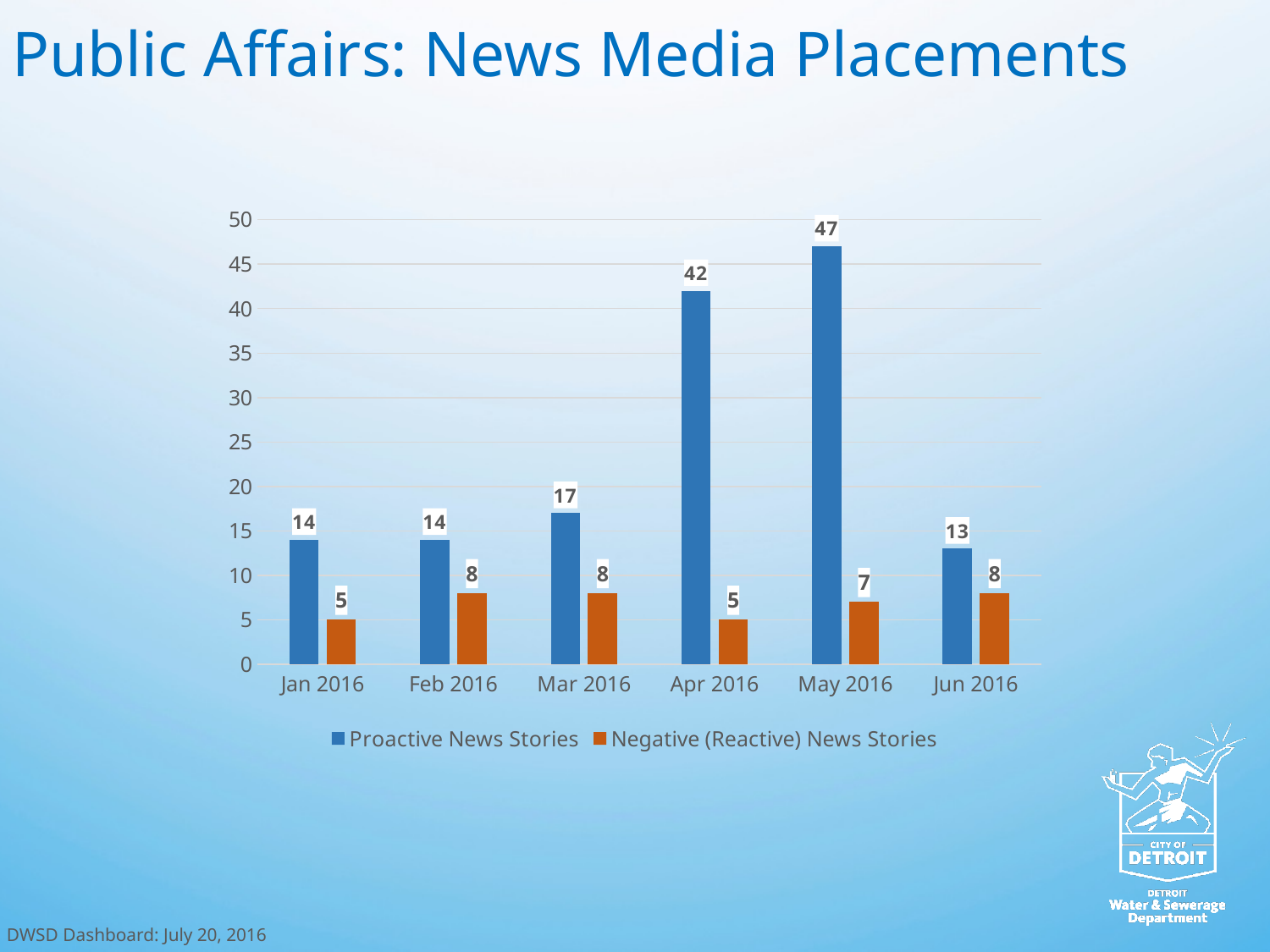
Is the value for Proactive News Stories in Apr 2016 greater or less than 40? greater How many months are shown on the x axis? 6 How many series does the legend list? 2 How many Proactive News Stories were there in Apr 2016? 42 Which is larger in Mar 2016: Proactive News Stories or Negative (Reactive) News Stories? Proactive News Stories Do Proactive News Stories rise or fall from Apr 2016 to Jun 2016? fall Which month has the lowest number of Proactive News Stories? Jun 2016 What kind of chart is shown on the slide? bar chart What colour are the bars for Negative (Reactive) News Stories? orange Which month has the highest number of Proactive News Stories? May 2016 What is the difference between Proactive News Stories and Negative (Reactive) News Stories in May 2016? 40 What is the value for Negative (Reactive) News Stories in May 2016? 7